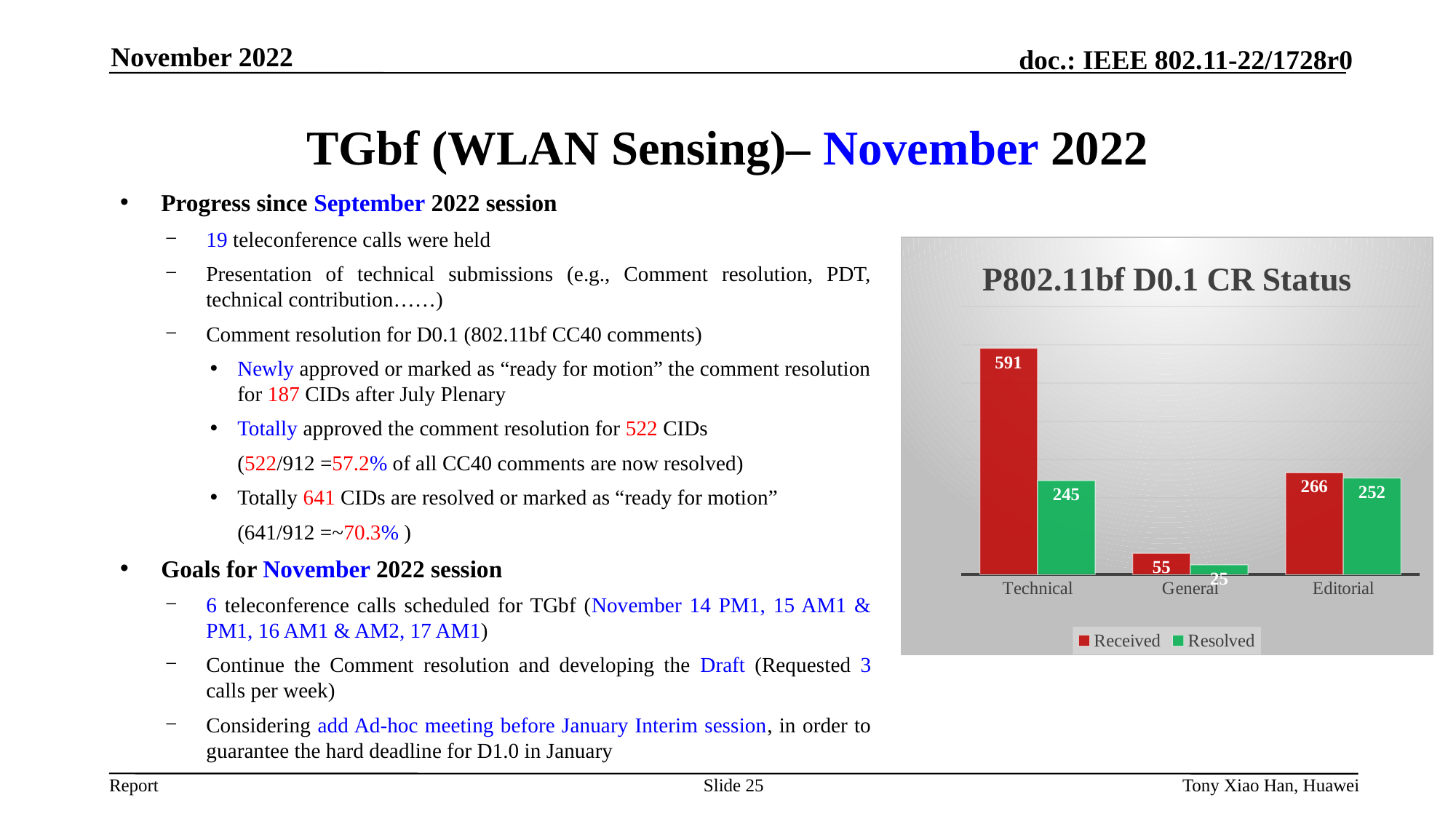
What is the difference between the Received and Resolved values for Technical? 346 What is the Resolved value for Technical? 245 What is the Resolved value for Editorial? 252 Which category has the highest Received value? Technical Which category has the lowest Resolved value? General How many categories are shown on the x axis of the chart? 3 What type of chart is shown on the slide? bar chart Which is larger for Editorial, the Received value or the Resolved value? Received What is the Received value for Technical? 591 What is the title of the chart? P802.11bf D0.1 CR Status How many series does the chart legend list? 2 What is the Received value for General? 55